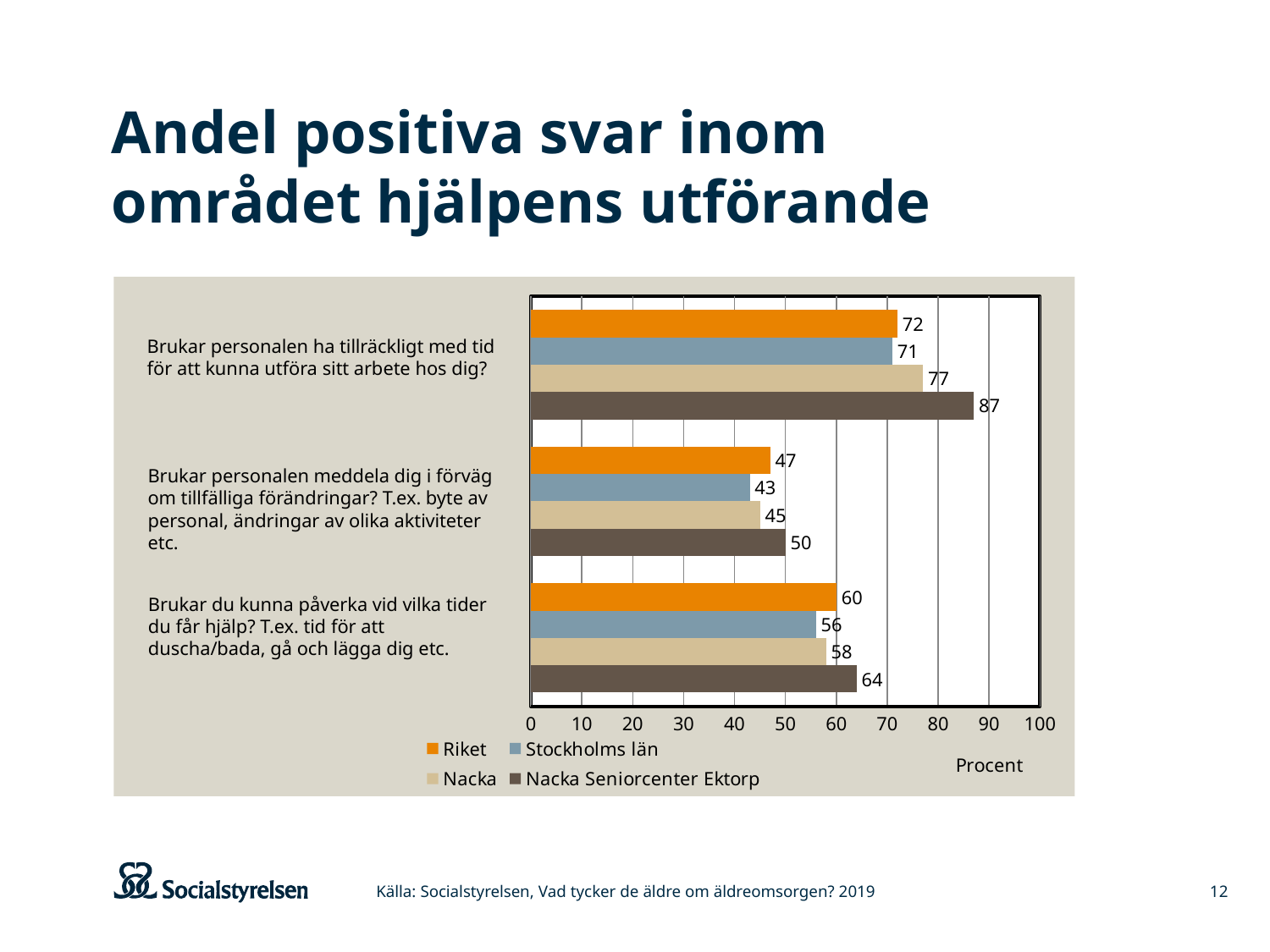
How many series does the legend list? 4 What is the label of the x axis? Procent For "Brukar du kunna påverka vid vilka tider du får hjälp?", which is larger: Nacka or Stockholms län? Nacka What is the value for Stockholms län for "Brukar du kunna påverka vid vilka tider du får hjälp?"? 56 Is the value for Nacka Seniorcenter Ektorp for "Brukar personalen meddela dig i förväg om tillfälliga förändringar?" greater or less than 60? less What is the value for Nacka Seniorcenter Ektorp for "Brukar personalen ha tillräckligt med tid för att kunna utföra sitt arbete hos dig?"? 87 How many question categories are plotted on the chart? 3 Which series has the highest value for "Brukar personalen ha tillräckligt med tid för att kunna utföra sitt arbete hos dig?"? Nacka Seniorcenter Ektorp Which series has the lowest value for "Brukar personalen meddela dig i förväg om tillfälliga förändringar?"? Stockholms län What is the difference between Nacka Seniorcenter Ektorp and Riket for "Brukar personalen ha tillräckligt med tid för att kunna utföra sitt arbete hos dig?"? 15 What kind of chart is shown on the slide? bar chart What is the value for Riket for "Brukar personalen meddela dig i förväg om tillfälliga förändringar?"? 47